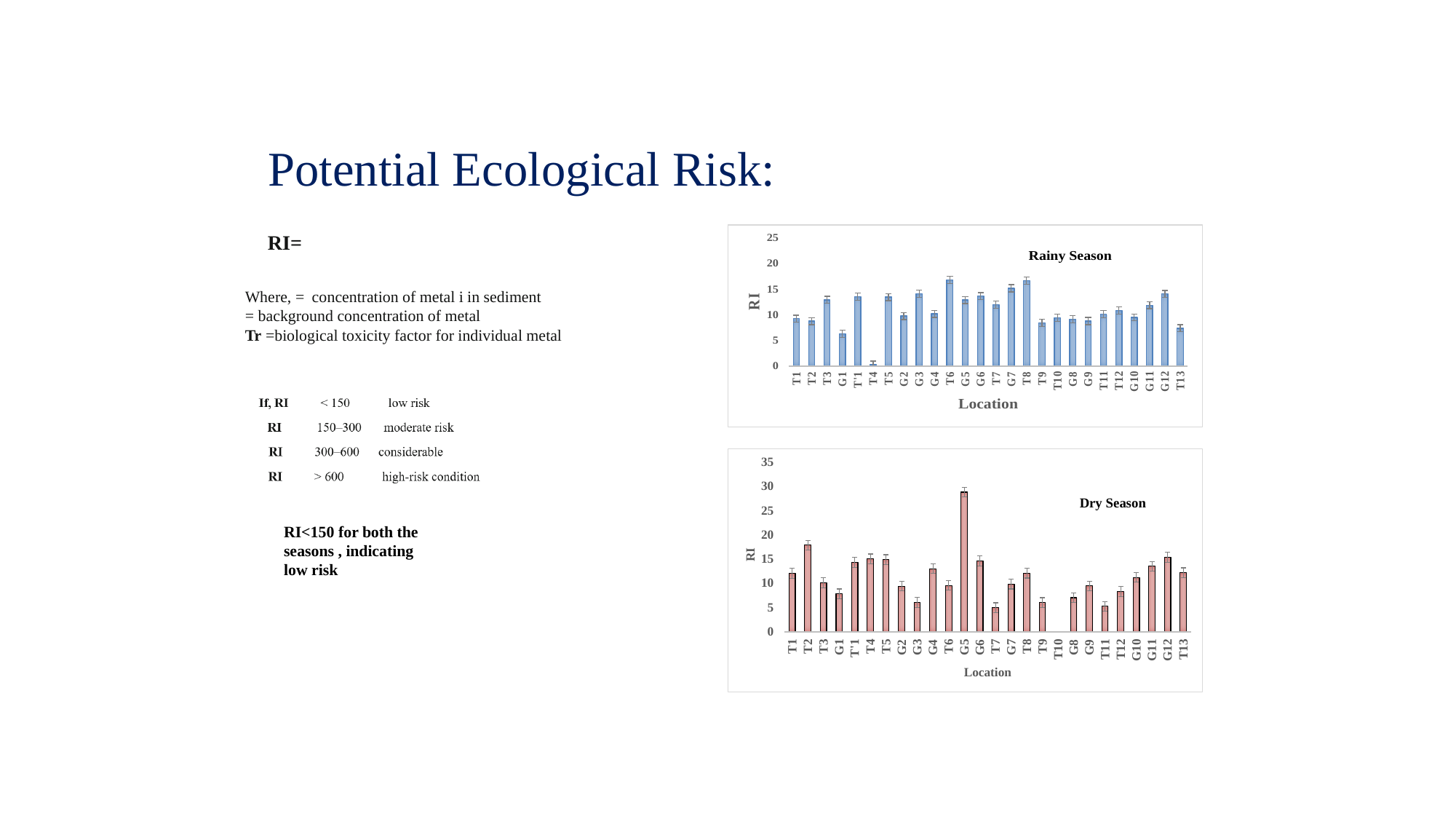
In the Rainy Season chart, is the value for G1 greater or less than 10? less In the Rainy Season chart, which location has the lowest RI value? T4 In the Dry Season chart, is the value for T2 greater or less than 15? greater In the Rainy Season chart, is the value for T6 greater or less than 15? greater What kind of chart is the Rainy Season chart? bar chart How many locations are shown on the x axis of the Dry Season chart? 26 In the Rainy Season chart, which has the larger RI value, T3 or G1? T3 In the Dry Season chart, which location has the highest RI value? G5 In the Dry Season chart, which has the larger RI value, T2 or T3? T2 What is the label of the y axis on the Rainy Season chart? RI